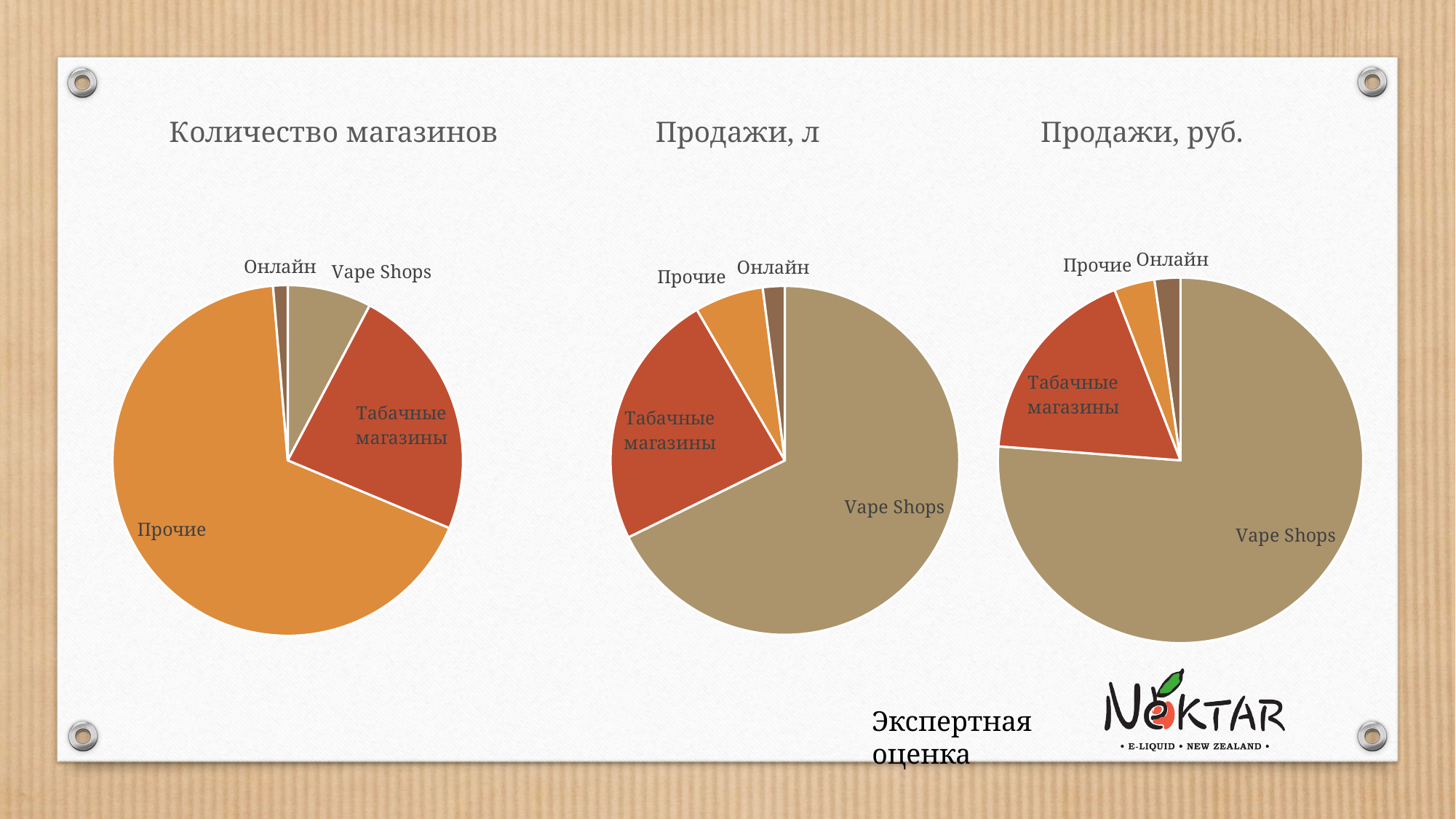
In the "Продажи, л" chart, which category has the smallest slice? Онлайн What is the title of the rightmost chart on the slide? Продажи, руб. How many charts are shown on the slide? 3 In the "Количество магазинов" chart, which category has the smallest slice? Онлайн In the "Продажи, руб." chart, which category has the largest slice? Vape Shops What kind of chart is the "Количество магазинов" chart? pie chart How many slices does the "Продажи, л" pie chart have? 4 In the "Продажи, руб." chart, which slice is larger: Прочие or Табачные магазины? Табачные магазины In the "Количество магазинов" chart, which slice is larger: Табачные магазины or Vape Shops? Табачные магазины In the "Количество магазинов" chart, which category has the largest slice? Прочие In the "Продажи, л" chart, which slice is larger: Табачные магазины or Прочие? Табачные магазины In the "Продажи, л" chart, which category has the largest slice? Vape Shops